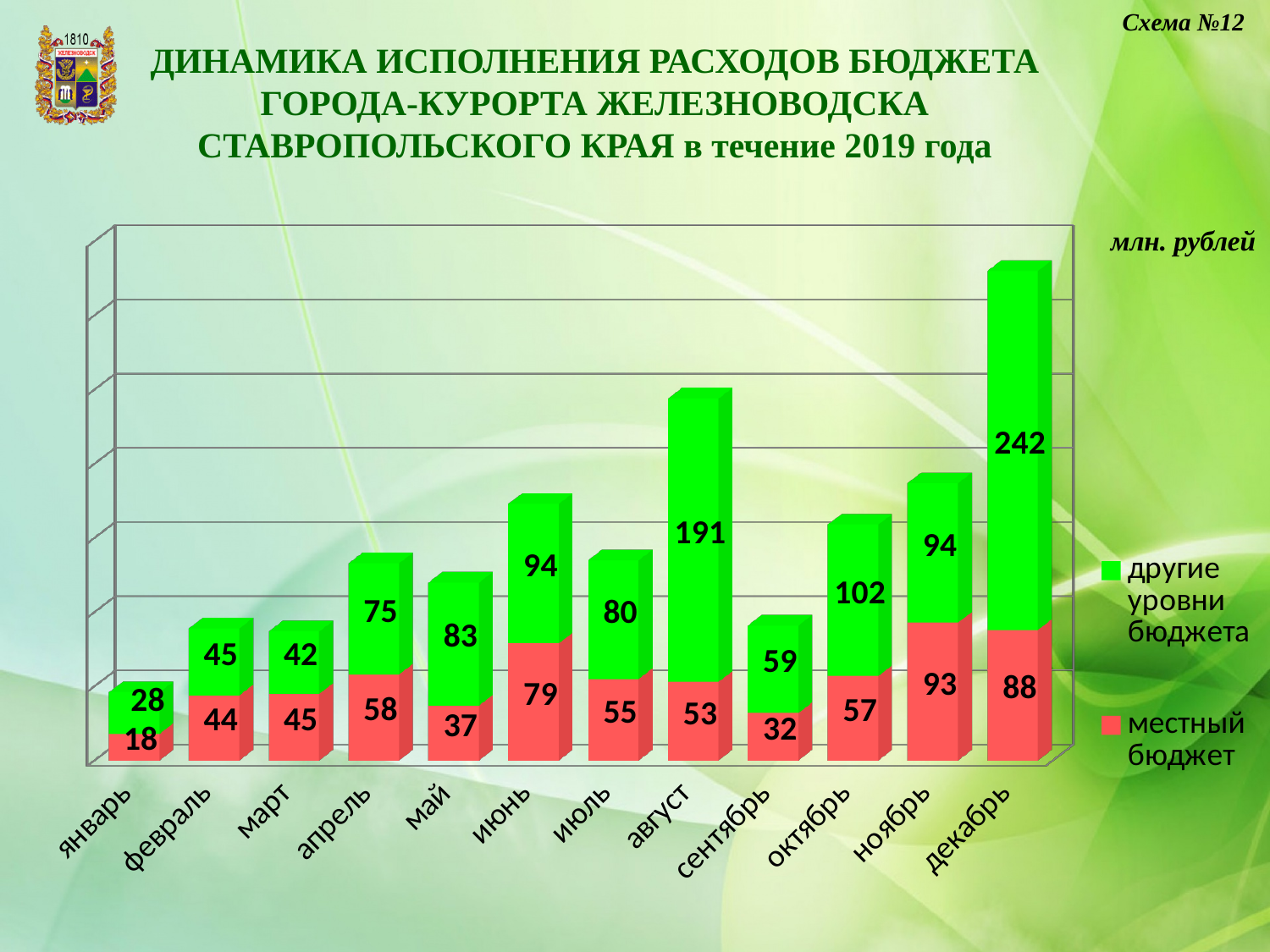
What is the value of 'местный бюджет' for январь? 18 Which is larger: the 'местный бюджет' value for ноябрь or for октябрь? ноябрь In which month is the value of 'другие уровни бюджета' the highest? декабрь What is the total of the stacked bar for декабрь? 330 How many months (categories) are shown on the x axis? 12 What unit is indicated for the values on the chart? млн. рублей What type of chart is shown on the slide? stacked bar chart What is the difference between the 'другие уровни бюджета' values for август and сентябрь? 132 In which month is the value of 'местный бюджет' the lowest? январь What is the value of 'местный бюджет' for июнь? 79 What is the value of 'другие уровни бюджета' for август? 191 How many series does the legend list? 2